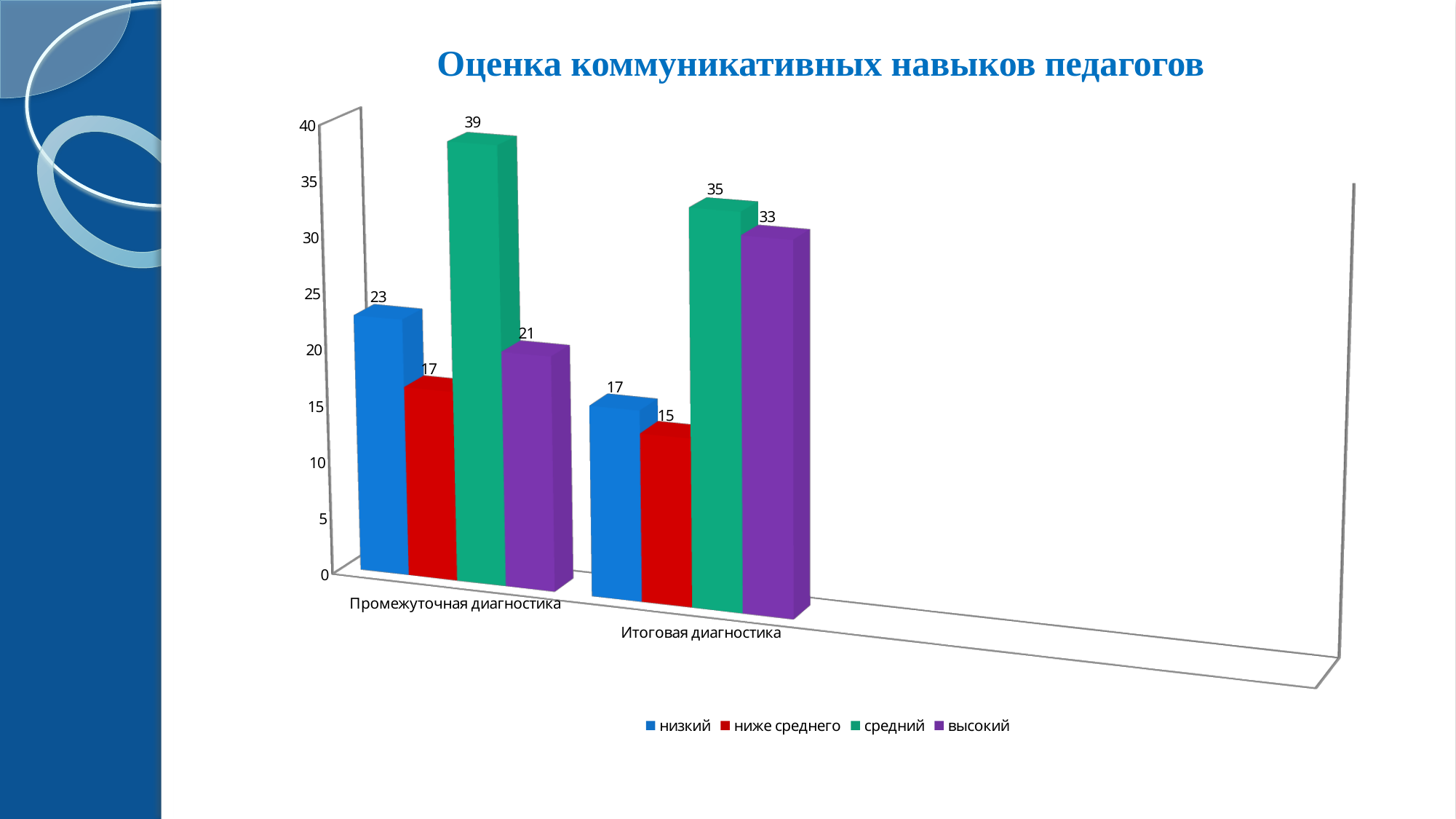
Which series has the highest value in "Итоговая диагностика"? средний Does the value for "средний" rise or fall from "Промежуточная диагностика" to "Итоговая диагностика"? fall What is the title of the chart? Оценка коммуникативных навыков педагогов What kind of chart is shown on the slide? bar chart Which series has the lowest value in "Промежуточная диагностика"? ниже среднего What is the value for "ниже среднего" in "Итоговая диагностика"? 15 What is the difference between the "высокий" values for "Итоговая диагностика" and "Промежуточная диагностика"? 12 What is the value for "средний" in "Промежуточная диагностика"? 39 How many categories are shown on the x axis? 2 Which is larger: "низкий" in "Промежуточная диагностика" or "низкий" in "Итоговая диагностика"? Промежуточная диагностика What is the value for "высокий" in "Итоговая диагностика"? 33 How many series does the legend list? 4